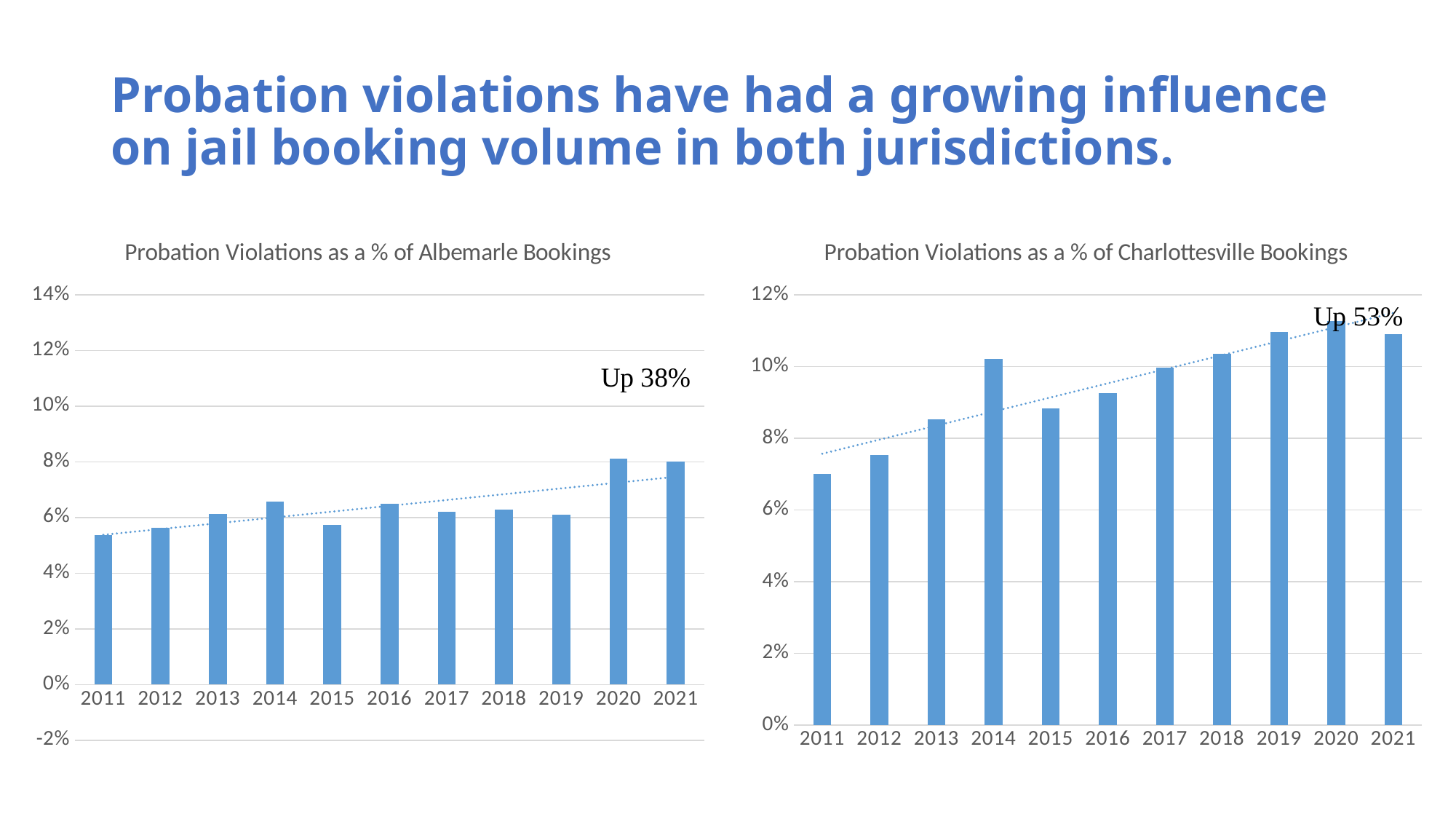
What percentage increase is annotated on the 'Probation Violations as a % of Albemarle Bookings' chart? Up 38% On the 'Probation Violations as a % of Charlottesville Bookings' chart, is the value for 2011 greater or less than 8%? less On the 'Probation Violations as a % of Albemarle Bookings' chart, is the value for 2011 greater or less than 6%? less On the 'Probation Violations as a % of Charlottesville Bookings' chart, which is larger, the value for 2014 or the value for 2013? 2014 On the 'Probation Violations as a % of Charlottesville Bookings' chart, which year has the lowest value? 2011 Do the values on the 'Probation Violations as a % of Charlottesville Bookings' chart generally rise or fall from 2011 to 2021? rise On the 'Probation Violations as a % of Charlottesville Bookings' chart, is the value for 2020 greater or less than 10%? greater How many years are plotted on the 'Probation Violations as a % of Charlottesville Bookings' chart? 11 On the 'Probation Violations as a % of Charlottesville Bookings' chart, which year has the highest value? 2020 What kind of chart is the 'Probation Violations as a % of Albemarle Bookings' chart? bar chart On the 'Probation Violations as a % of Albemarle Bookings' chart, which is larger, the value for 2020 or the value for 2015? 2020